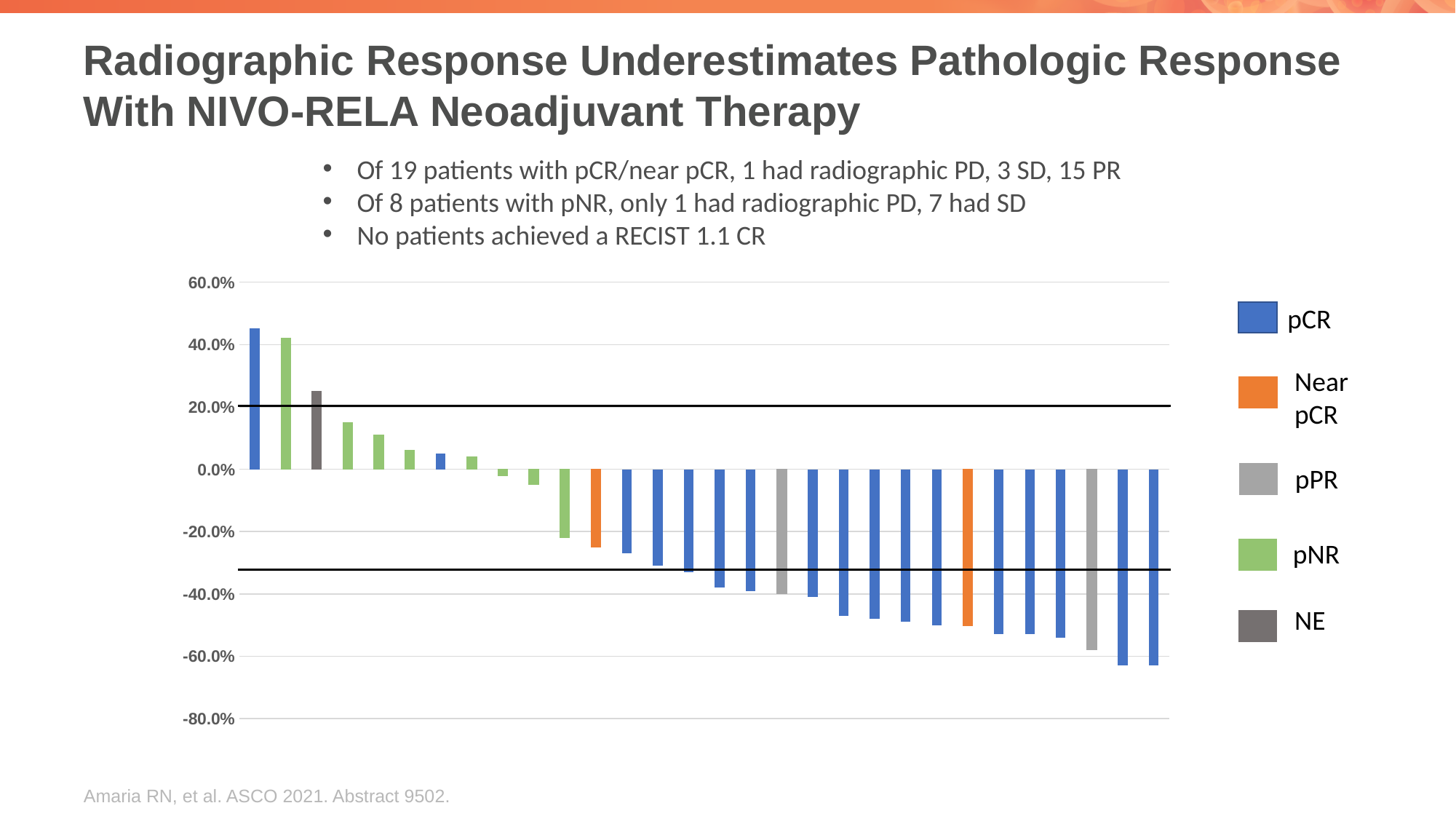
Is the value of the dark grey NE bar greater or less than 20.0%? greater Is the value of the lowest bar (the rightmost blue bar) greater or less than -60.0%? less Which legend entry is shown in green? pNR Do the bar values rise or fall from left to right across the chart? fall What kind of chart is shown on the slide? bar chart How many bars are plotted in the chart? 30 How many entries does the chart legend list? 5 Which legend entry is shown in blue? pCR Is the value of the leftmost green (pNR) bar greater or less than 40.0%? greater Which legend category does the tallest positive bar belong to? pCR How many bars have a positive value (extend above 0.0%)? 8